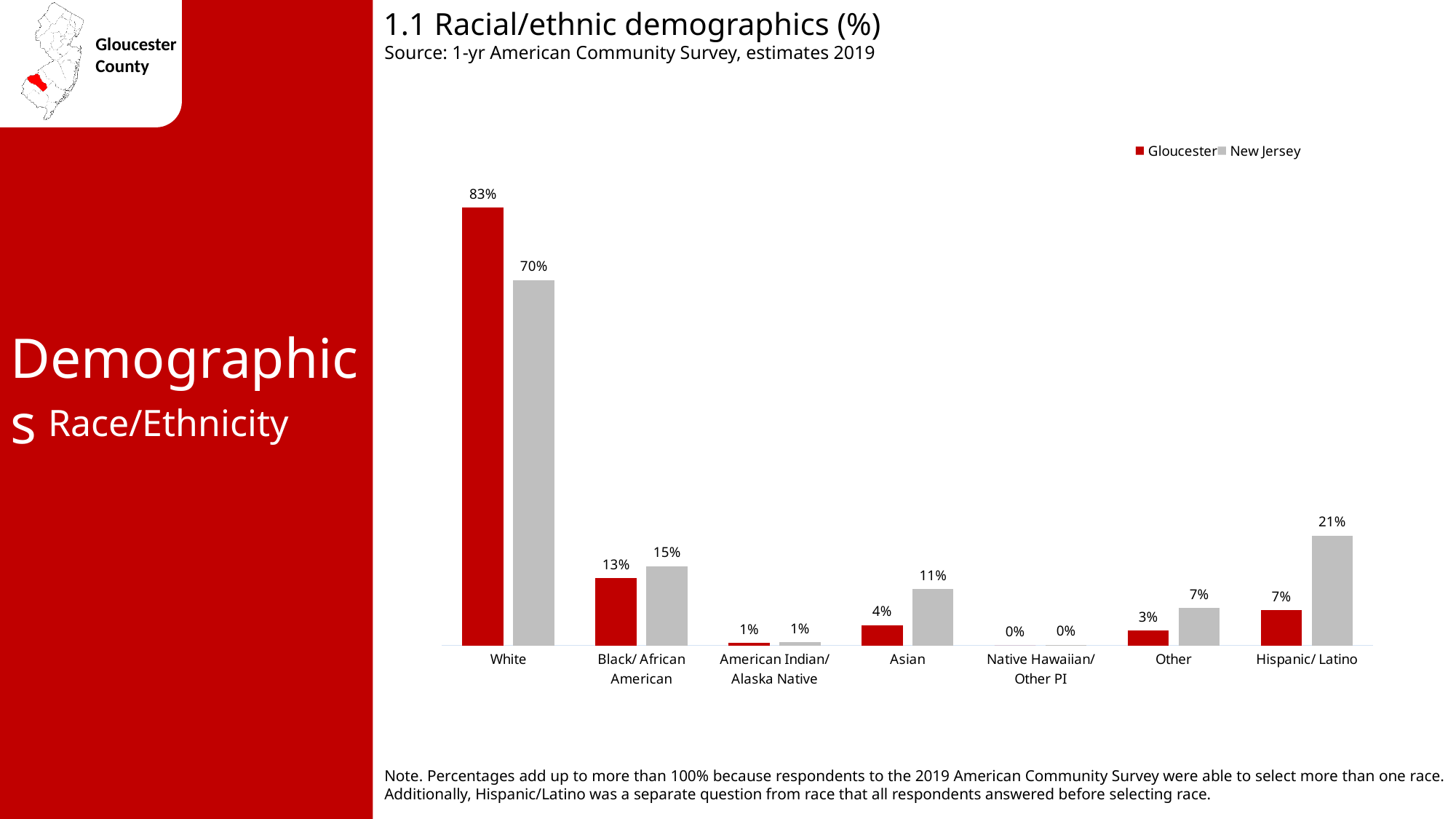
Which category has the lowest New Jersey value? Native Hawaiian/ Other PI How many categories are shown on the x axis? 7 What is the Gloucester value for Other? 3% What is the Gloucester value for White? 83% What is the New Jersey value for Hispanic/ Latino? 21% Which is larger for Black/ African American, the Gloucester value or the New Jersey value? New Jersey What is the New Jersey value for Asian? 11% Which category has the highest Gloucester value? White What kind of chart is shown on the slide? Bar chart What is the difference between the New Jersey and Gloucester values for Hispanic/ Latino? 14% What is the difference between the Gloucester and New Jersey values for White? 13% How many series does the legend list? 2